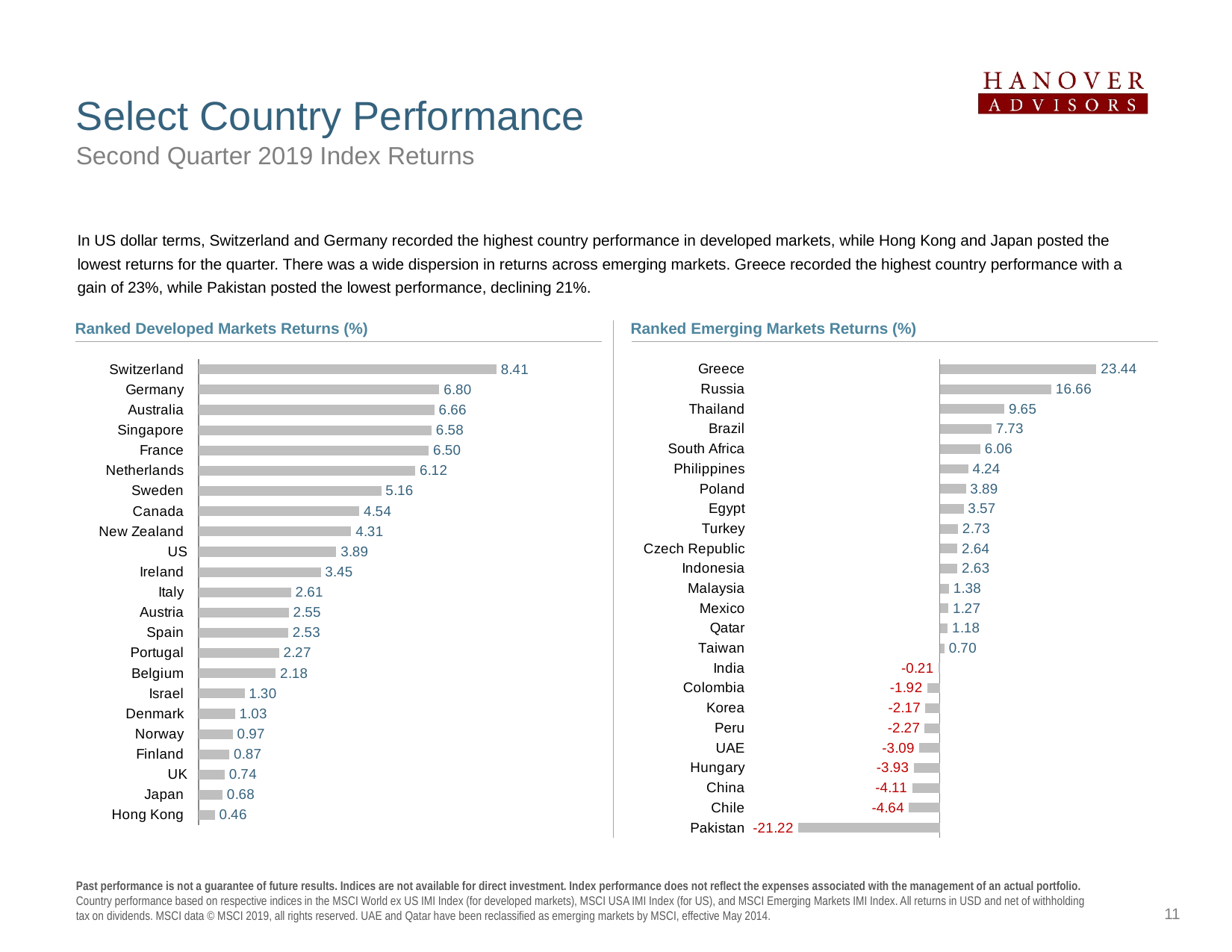
How many countries are shown in the Ranked Emerging Markets Returns (%) chart? 24 What kind of chart is the Ranked Emerging Markets Returns (%) chart? Bar chart In the Ranked Developed Markets Returns (%) chart, what is the difference between Germany and Japan? 6.12 In the Ranked Developed Markets Returns (%) chart, which country has the lowest value? Hong Kong In the Ranked Emerging Markets Returns (%) chart, what is the value for Taiwan? 0.70 How many countries are shown in the Ranked Developed Markets Returns (%) chart? 23 In the Ranked Emerging Markets Returns (%) chart, which country has the highest value? Greece In the Ranked Emerging Markets Returns (%) chart, which is larger, the value for Thailand or the value for Brazil? Thailand In the Ranked Emerging Markets Returns (%) chart, what is the difference between Greece and Russia? 6.78 In the Ranked Emerging Markets Returns (%) chart, what is the value for Pakistan? -21.22 In the Ranked Developed Markets Returns (%) chart, what is the value for Switzerland? 8.41 In the Ranked Developed Markets Returns (%) chart, which is larger, the value for Canada or the value for Sweden? Sweden